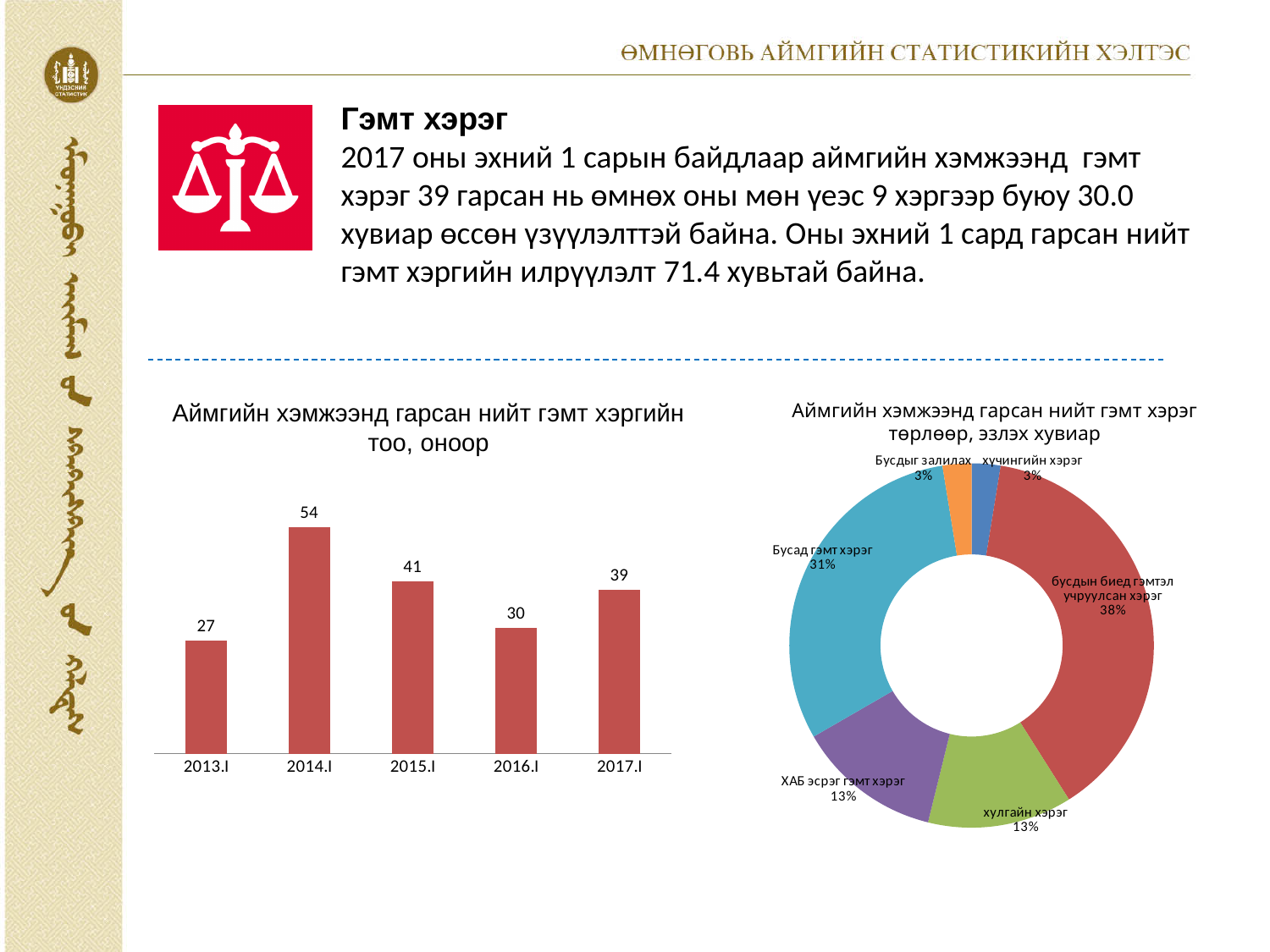
In the bar chart on the left, which year has the lowest value? 2013.I What kind of chart is the chart on the left? Bar chart How many categories are shown in the doughnut chart on the right? 6 In the doughnut chart on the right, which category has the largest share? бусдын биед гэмтэл учруулсан хэрэг In the bar chart on the left, what is the value for 2014.I? 54 How many bars are in the bar chart on the left? 5 In the doughnut chart on the right, what share does 'бусдын биед гэмтэл учруулсан хэрэг' have? 38% In the doughnut chart on the right, what share does 'Бусад гэмт хэрэг' have? 31% In the bar chart on the left, which is larger, the value for 2015.I or the value for 2017.I? 2015.I In the bar chart on the left, which year has the highest value? 2014.I In the bar chart on the left, what is the value for 2017.I? 39 In the bar chart on the left, what is the difference between the values for 2014.I and 2016.I? 24